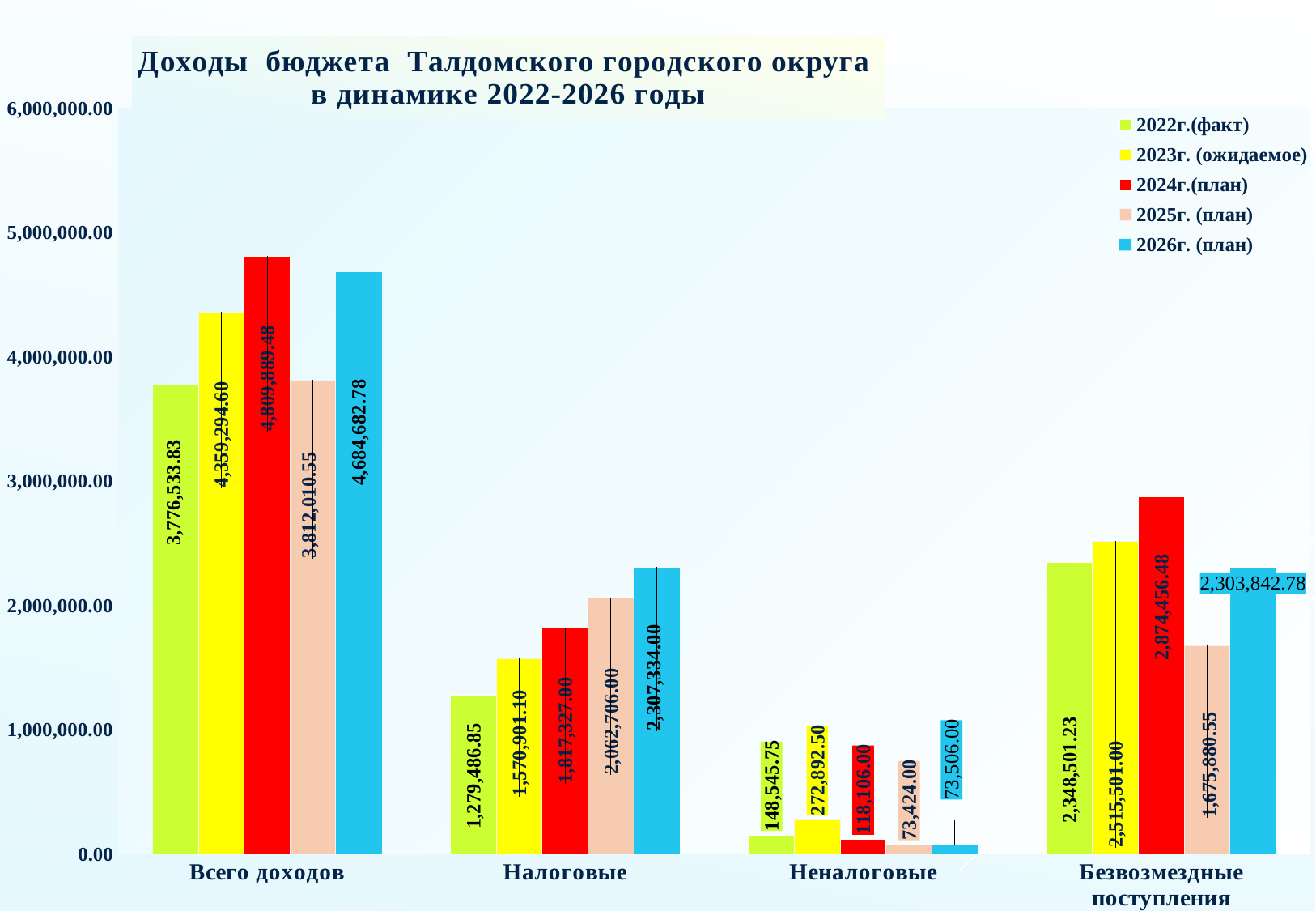
In the Безвозмездные поступления category, which is larger: the 2022г.(факт) value or the 2026г. (план) value? 2022г.(факт) Which series has the lowest value in the Налоговые category? 2022г.(факт) Is the value for 2025г. (план) in the Всего доходов category greater or less than 4,000,000.00? less How many series does the legend list? 5 What is the value for 2025г. (план) in the Безвозмездные поступления category? 1,675,880.55 What is the difference between the 2026г. (план) and 2022г.(факт) values in the Налоговые category? 1,027,847.15 How many categories are shown on the x axis? 4 What is the value for 2026г. (план) in the Налоговые category? 2,307,334.00 What is the value for 2022г.(факт) in the Всего доходов category? 3,776,533.83 Do the values in the Налоговые category rise or fall from 2022г.(факт) to 2026г. (план)? rise What is the value for 2023г. (ожидаемое) in the Неналоговые category? 272,892.50 Which series has the highest value in the Всего доходов category? 2024г.(план)